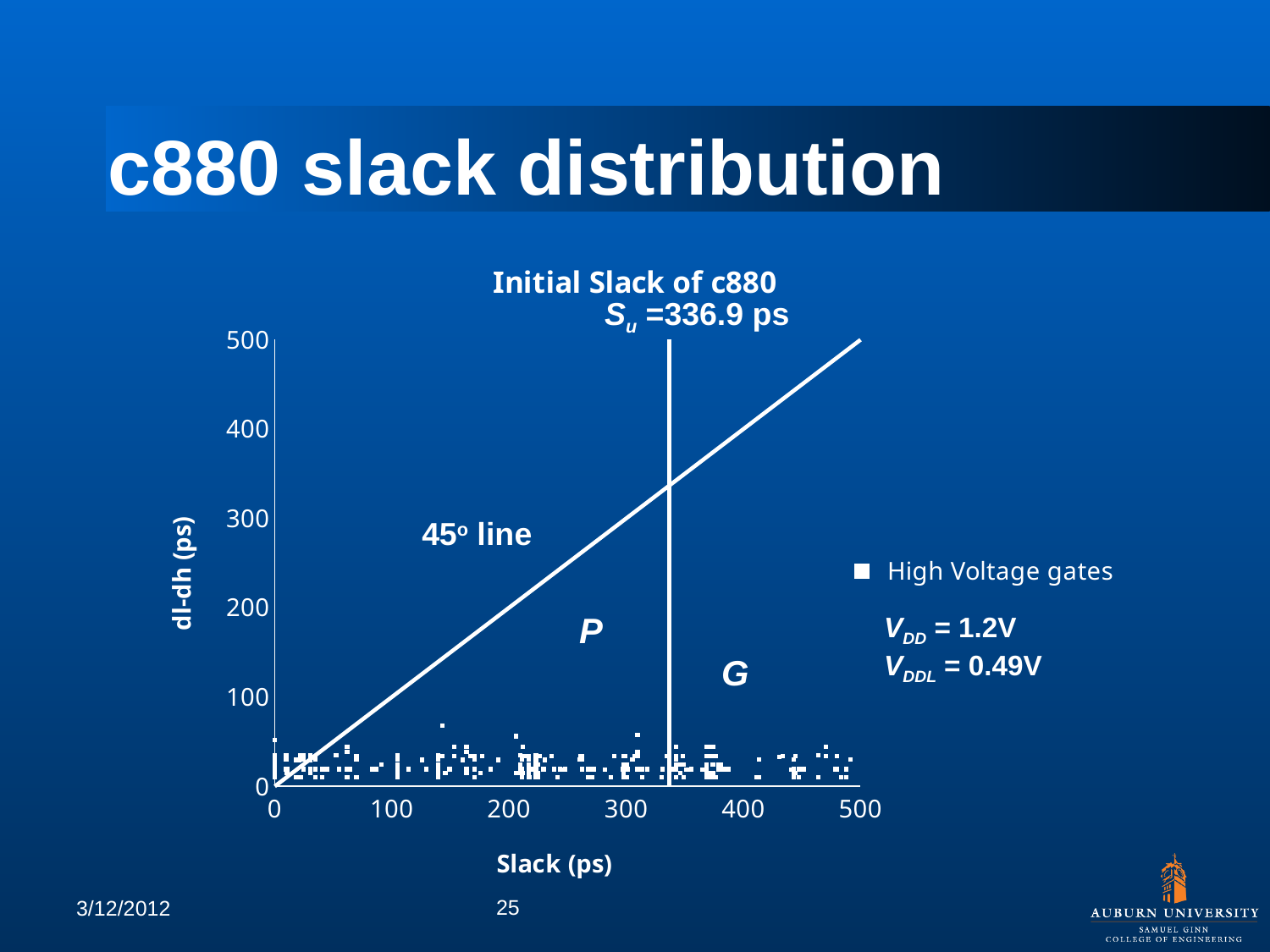
What kind of chart is shown on the slide? scatter chart What is the VDDL value annotated next to the chart? 0.49V Are the dl-dh values of the plotted High Voltage gates points greater or less than 100? less What is the highest tick value shown on the y axis? 500 What series name is shown in the chart legend? High Voltage gates What is the VDD value annotated next to the chart? 1.2V What value of Su is annotated on the chart? 336.9 ps What is the label of the y axis of the chart? dl-dh (ps) How many series does the chart legend list? 1 What is the title of the chart? Initial Slack of c880 What is the highest tick value shown on the x axis? 500 What is the label of the x axis of the chart? Slack (ps)